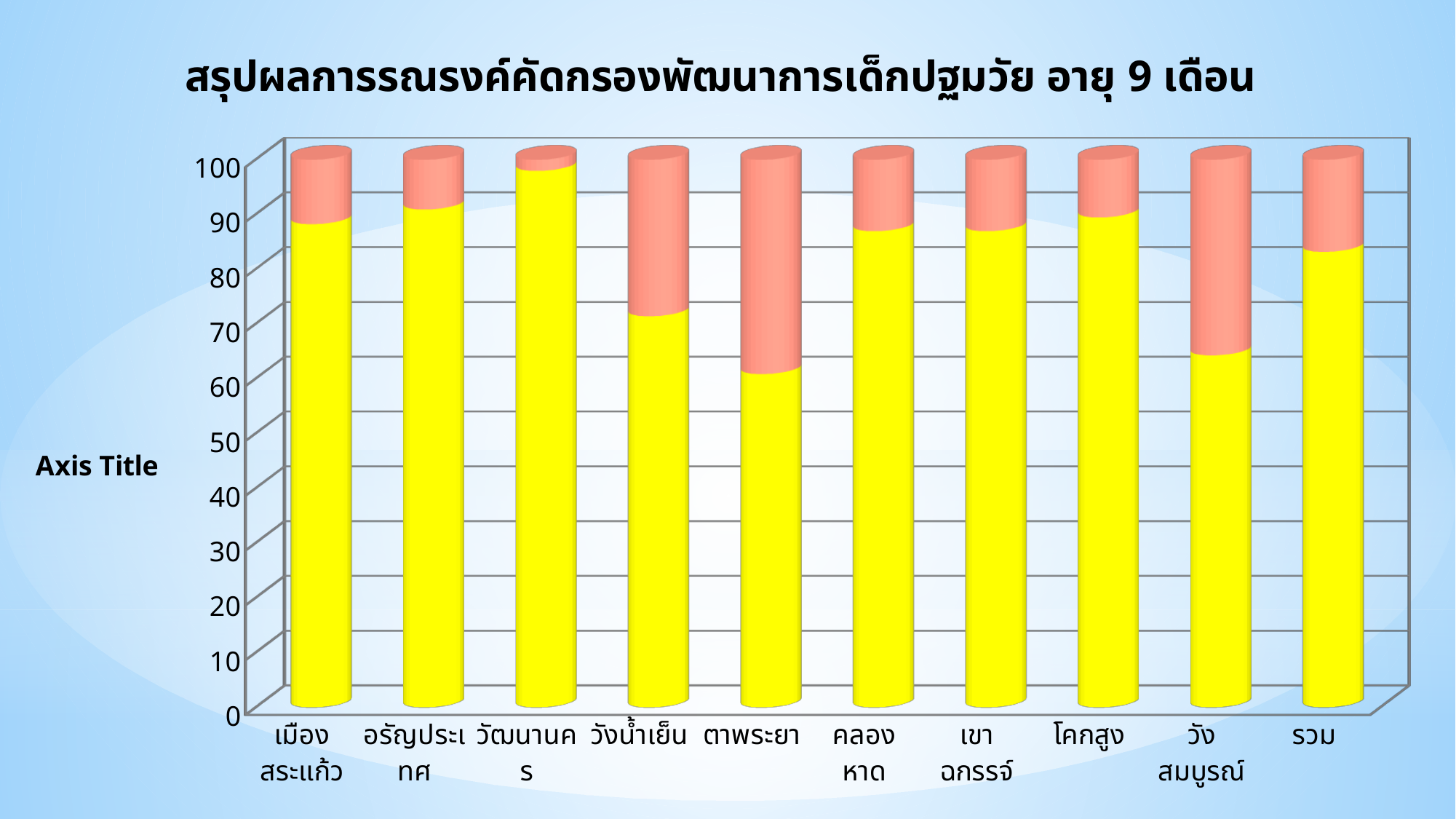
Is the yellow segment for วัฒนานคร greater or less than 90? greater What is the title of the chart? สรุปผลการรณรงค์คัดกรองพัฒนาการเด็กปฐมวัย อายุ 9 เดือน How many categories are shown along the x axis of the chart? 10 Which category has the shortest yellow segment? ตาพระยา What is the total height of the stacked bar for ตาพระยา? 100 Is the yellow segment for ตาพระยา greater or less than 70? less Which category has the tallest yellow segment? วัฒนานคร Is the yellow segment for รวม greater or less than 80? greater What is the label shown on the vertical axis of the chart? Axis Title Which has the larger yellow segment, อรัญประเทศ or วังสมบูรณ์? อรัญประเทศ What kind of chart is shown on the slide? Stacked bar chart